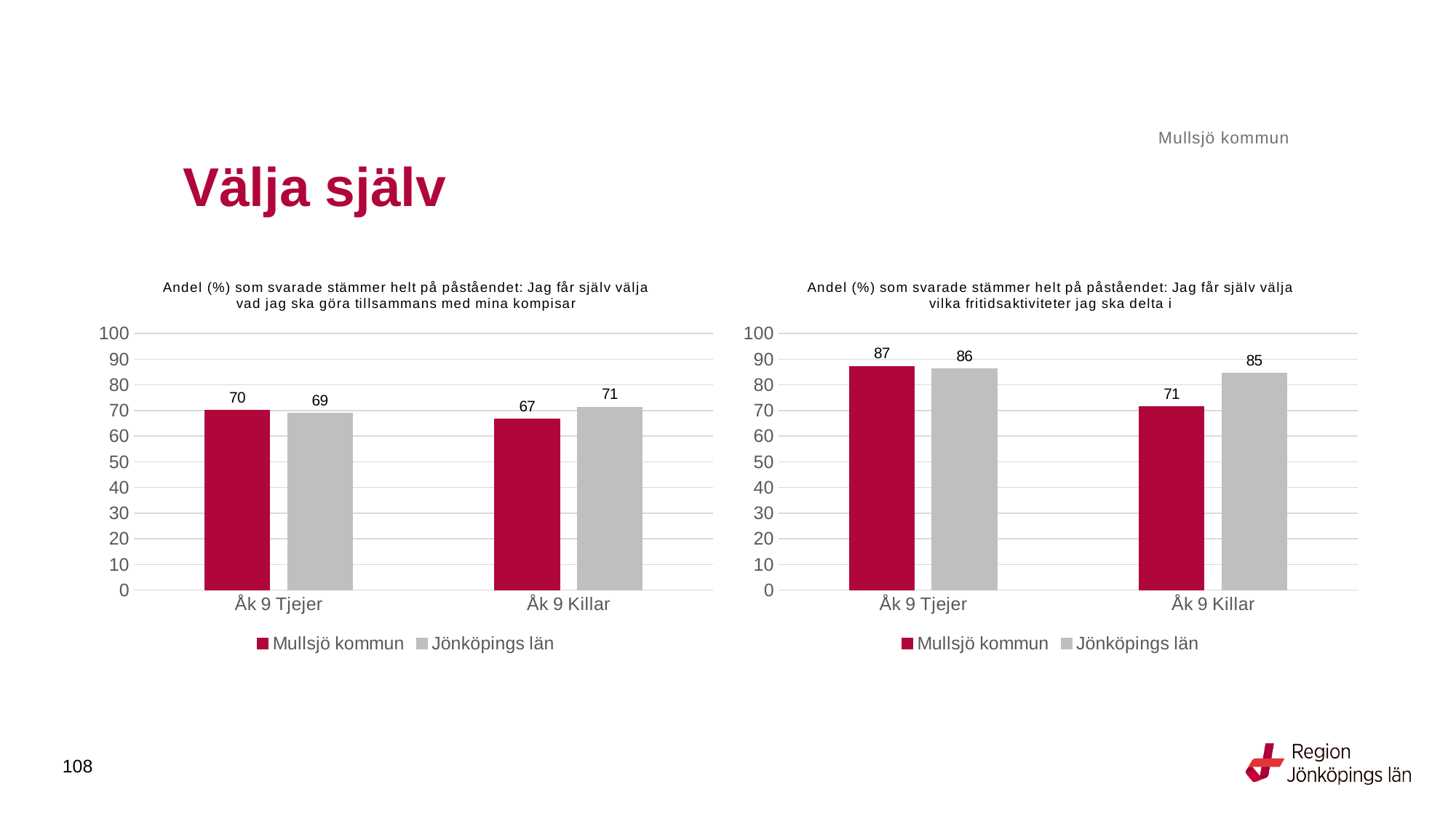
In the left chart (about choosing what to do with friends), which bar has the lowest value? Mullsjö kommun, Åk 9 Killar In the left chart (about choosing what to do with friends), what is the value for Mullsjö kommun for Åk 9 Tjejer? 70 In the left chart (about choosing what to do with friends), what is the value for Jönköpings län for Åk 9 Killar? 71 What kind of chart is the right chart (about choosing leisure activities)? Bar chart In the right chart (about choosing leisure activities), what is the difference between Jönköpings län and Mullsjö kommun for Åk 9 Killar? 14 How many categories are shown on the x axis of the right chart (about choosing leisure activities)? 2 How many series does the legend of the left chart list? 2 In the right chart (about choosing leisure activities), what is the value for Mullsjö kommun for Åk 9 Tjejer? 87 In the left chart (about choosing what to do with friends), what is the difference between Jönköpings län and Mullsjö kommun for Åk 9 Killar? 4 In the right chart (about choosing leisure activities), which is larger for Åk 9 Killar: Mullsjö kommun or Jönköpings län? Jönköpings län In the right chart (about choosing leisure activities), what is the value for Jönköpings län for Åk 9 Killar? 85 In the right chart (about choosing leisure activities), which bar has the highest value? Mullsjö kommun, Åk 9 Tjejer